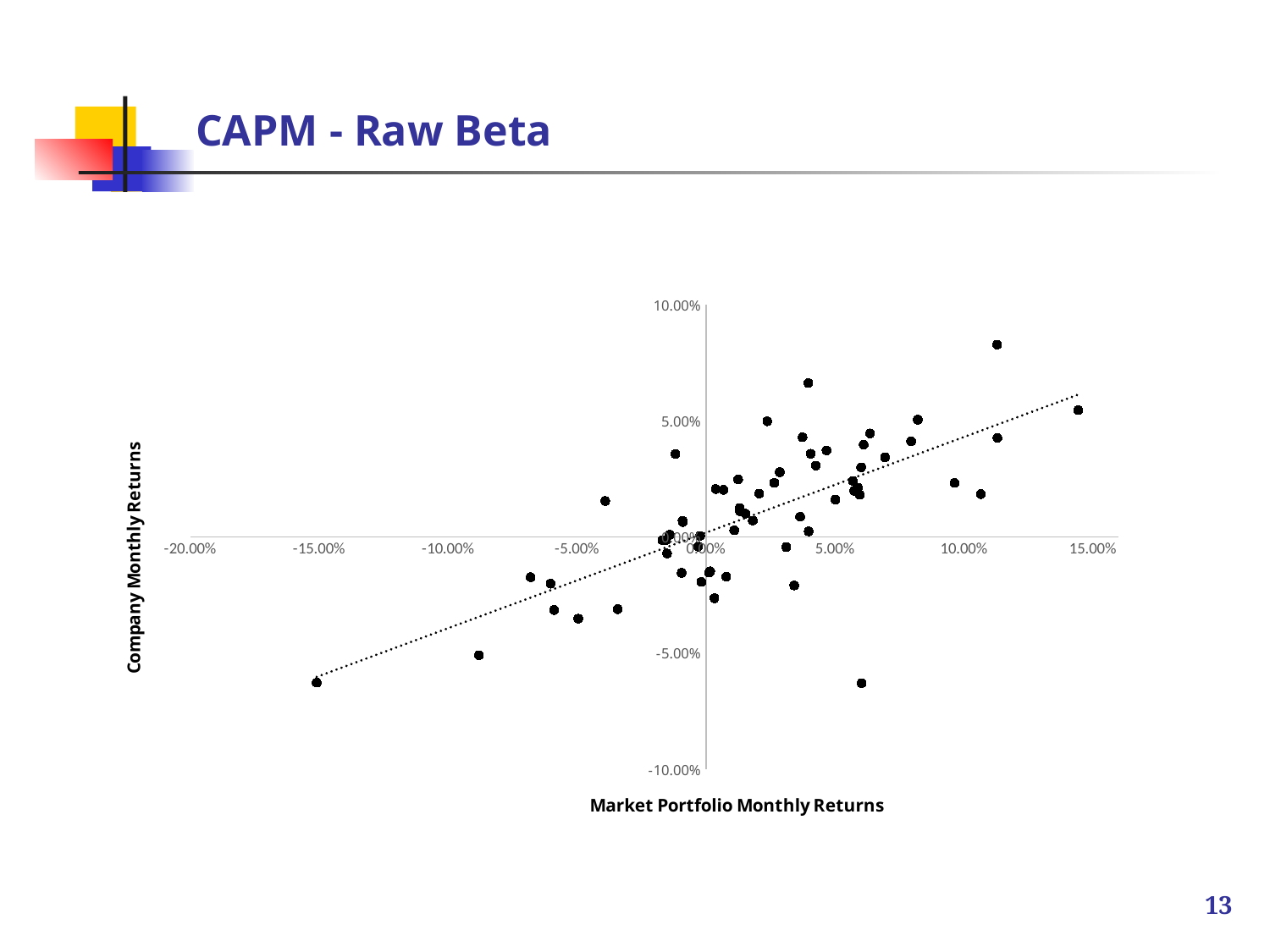
Does the dotted trend line slope upward or downward from left to right? Upward What is the maximum value shown on the y axis? 10.00% What kind of chart is shown on the slide? Scatter chart What is the minimum value shown on the x axis? -20.00% Is the Market Portfolio Monthly Return of the rightmost plotted point greater or less than 10.00%? greater Is the Market Portfolio Monthly Return of the leftmost plotted point greater or less than -10.00%? less What is the label of the x axis? Market Portfolio Monthly Returns Is the Company Monthly Return of the highest plotted point greater or less than 5.00%? greater Do the plotted points generally rise or fall as Market Portfolio Monthly Returns increase along the x axis? Rise